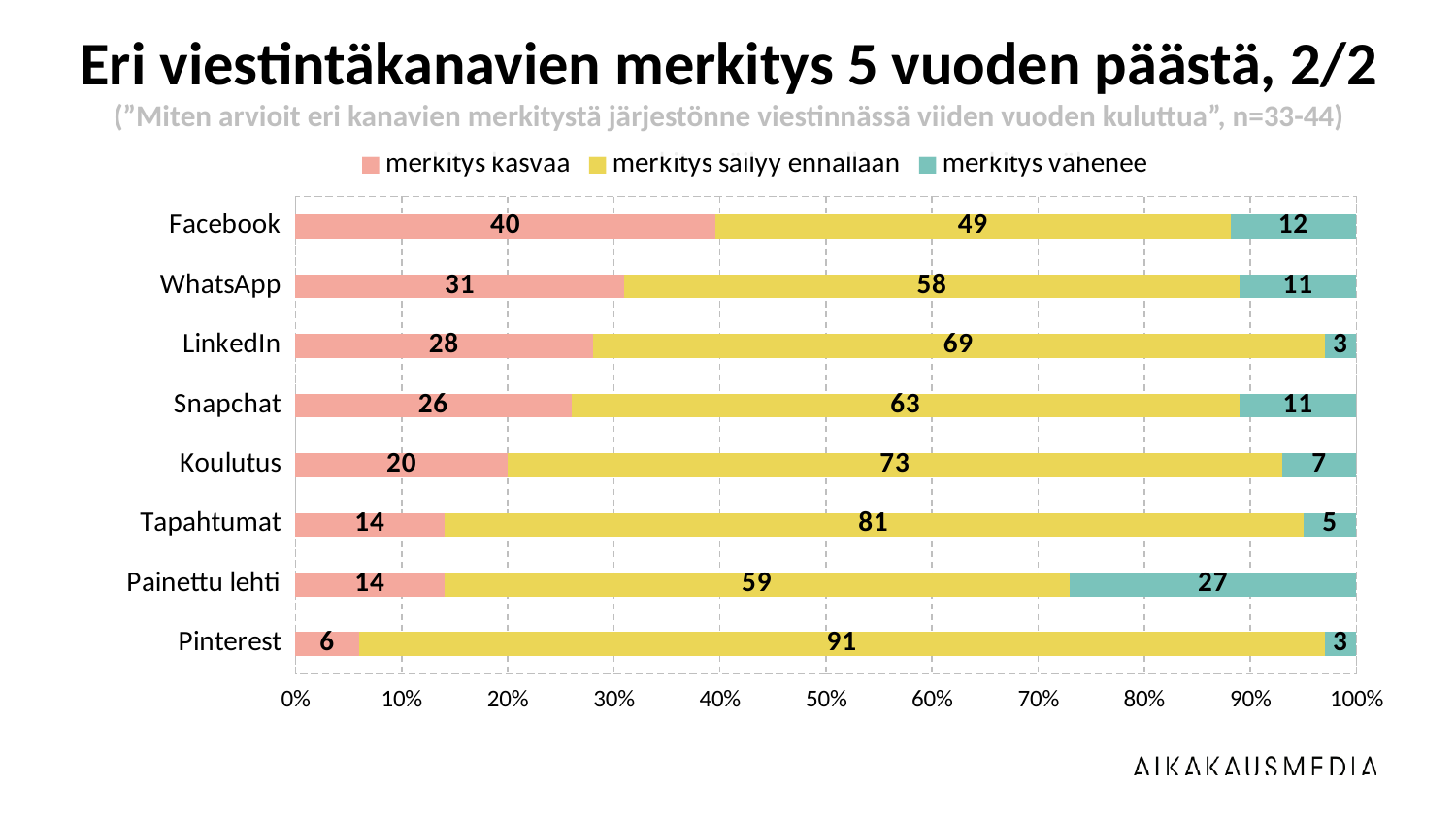
What is the value for Facebook in the "merkitys kasvaa" series? 40 Which category has the lowest value in the "merkitys säilyy ennallaan" series? Facebook Which is larger: the "merkitys kasvaa" value for WhatsApp or for Snapchat? WhatsApp How many categories are shown on the y axis? 8 Which category has the highest value in the "merkitys vähenee" series? Painettu lehti What kind of chart is shown on the slide? Stacked bar chart Which category has the highest value in the "merkitys kasvaa" series? Facebook What is the difference between the "merkitys säilyy ennallaan" values for Tapahtumat and Koulutus? 8 What is the value for Painettu lehti in the "merkitys vähenee" series? 27 How many series does the legend list? 3 What is the value for Pinterest in the "merkitys säilyy ennallaan" series? 91 What is the total of the stacked bar for LinkedIn? 100